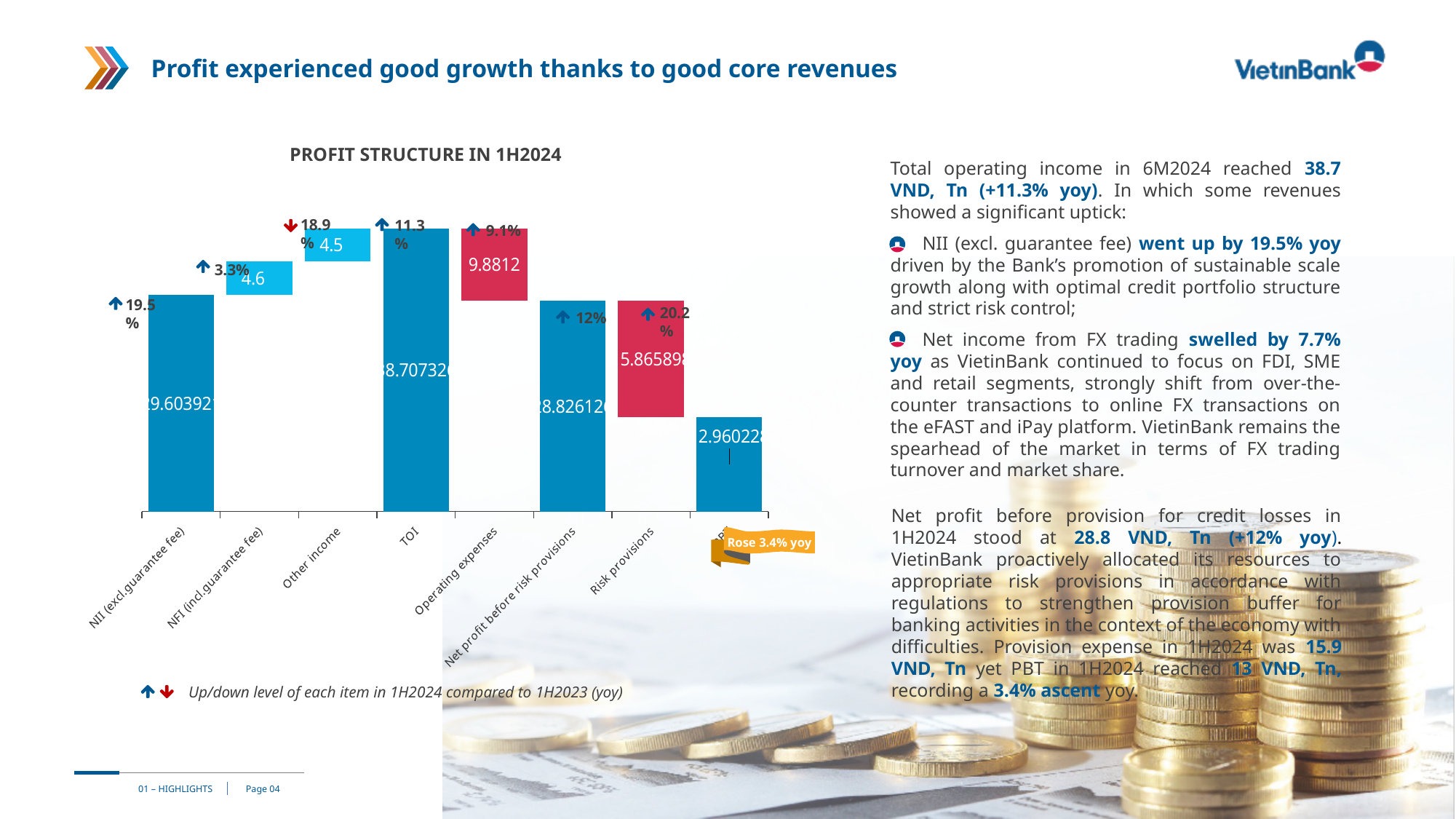
What is the value shown for NFI (incl. guarantee fee)? 4.6 What is the year-on-year change shown for Net profit before risk provisions? 12% What is the title of the chart? PROFIT STRUCTURE IN 1H2024 Which item has the tallest bar in the chart? TOI What is the value shown for Operating expenses? 9.8812 Which item is marked with a downward arrow (a decrease compared to 1H2023)? Other income What is the year-on-year change shown for Risk provisions? 20.2% What is the year-on-year change shown for NII (excl. guarantee fee)? 19.5% What kind of chart is shown on the slide? bar chart How many bars are plotted in the chart? 8 What is the value shown for Other income? 4.5 What is the difference between the NFI (incl. guarantee fee) value and the Other income value? 0.1